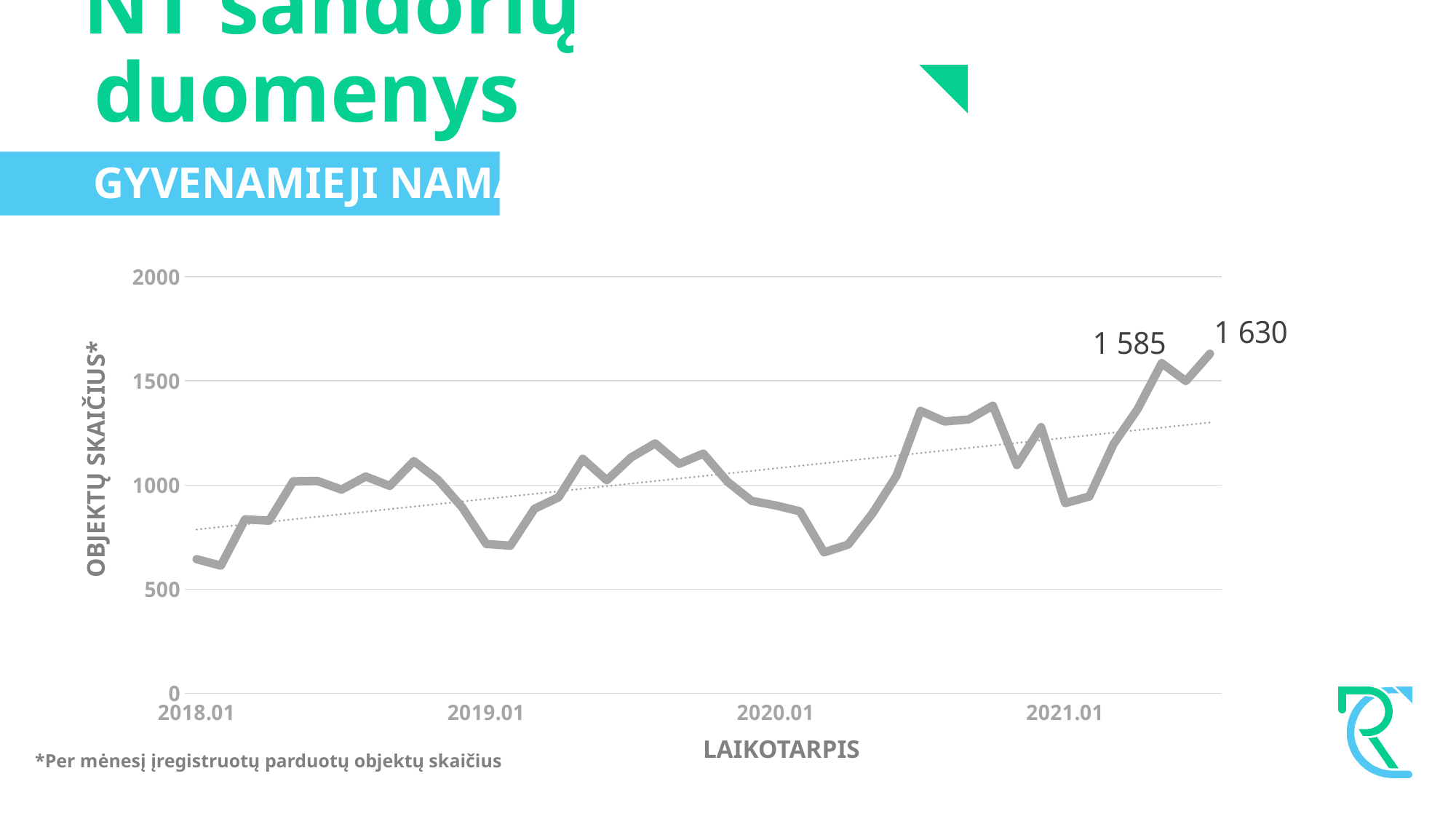
Is the value at 2018.01 greater or less than 1000? less Is the value at 2019.01 greater or less than 1000? less What is the title of the vertical axis? OBJEKTŲ SKAIČIUS* Which is larger: the last data point or the earlier labeled peak? the last data point (1 630) What type of chart is shown on the slide? line chart Do the values generally rise or fall from 2018.01 to the end of the series? rise How many year labels are shown on the x axis? 4 What is the value of the labeled peak just before the last data point? 1 585 What is the highest value shown on the chart? 1 630 What is the value of the last data point on the line? 1 630 What is the title of the horizontal axis? LAIKOTARPIS What is the difference between the last data point (1 630) and the earlier labeled peak (1 585)? 45